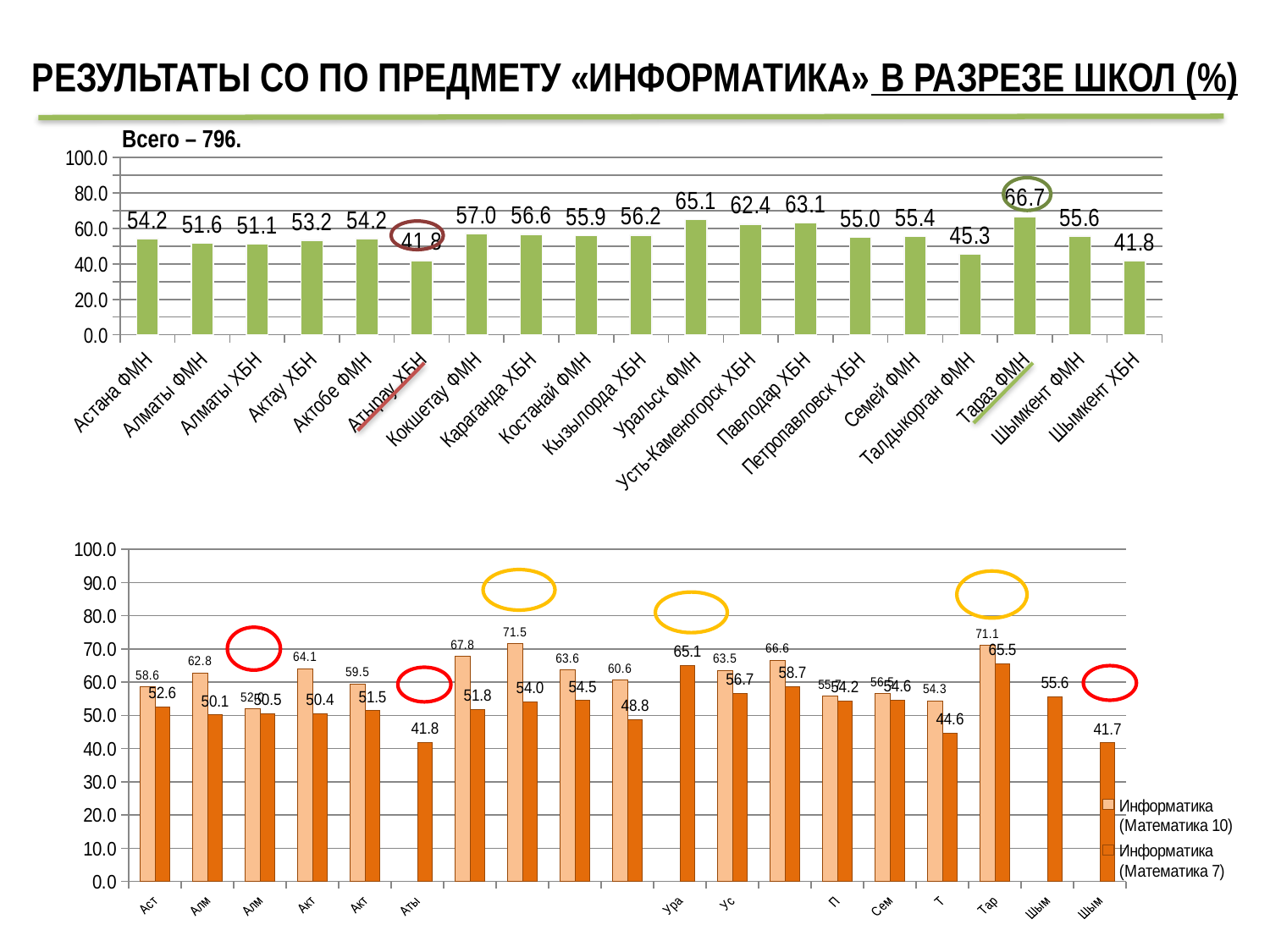
What kind of chart is the top chart? bar chart In the bottom chart, how many series does the legend list? 2 In the bottom chart, what is the value of Информатика (Математика 7) for Аты? 41.8 In the top chart, what is the value for Уральск ФМН? 65.1 In the top chart, which is larger: the value for Кокшетау ФМН or the value for Караганда ХБН? Кокшетау ФМН In the top chart, which school has the highest value? Тараз ФМН In the bottom chart, is the Информатика (Математика 7) value for Ура greater or less than 60? greater In the bottom chart, what is the value of Информатика (Математика 10) for Тар? 71.1 In the top chart, what is the difference between the values for Павлодар ХБН and Талдыкорган ФМН? 17.8 What total is stated above the top chart? Всего – 796. In the top chart, what is the value for Тараз ФМН? 66.7 In the top chart, how many schools are shown? 19